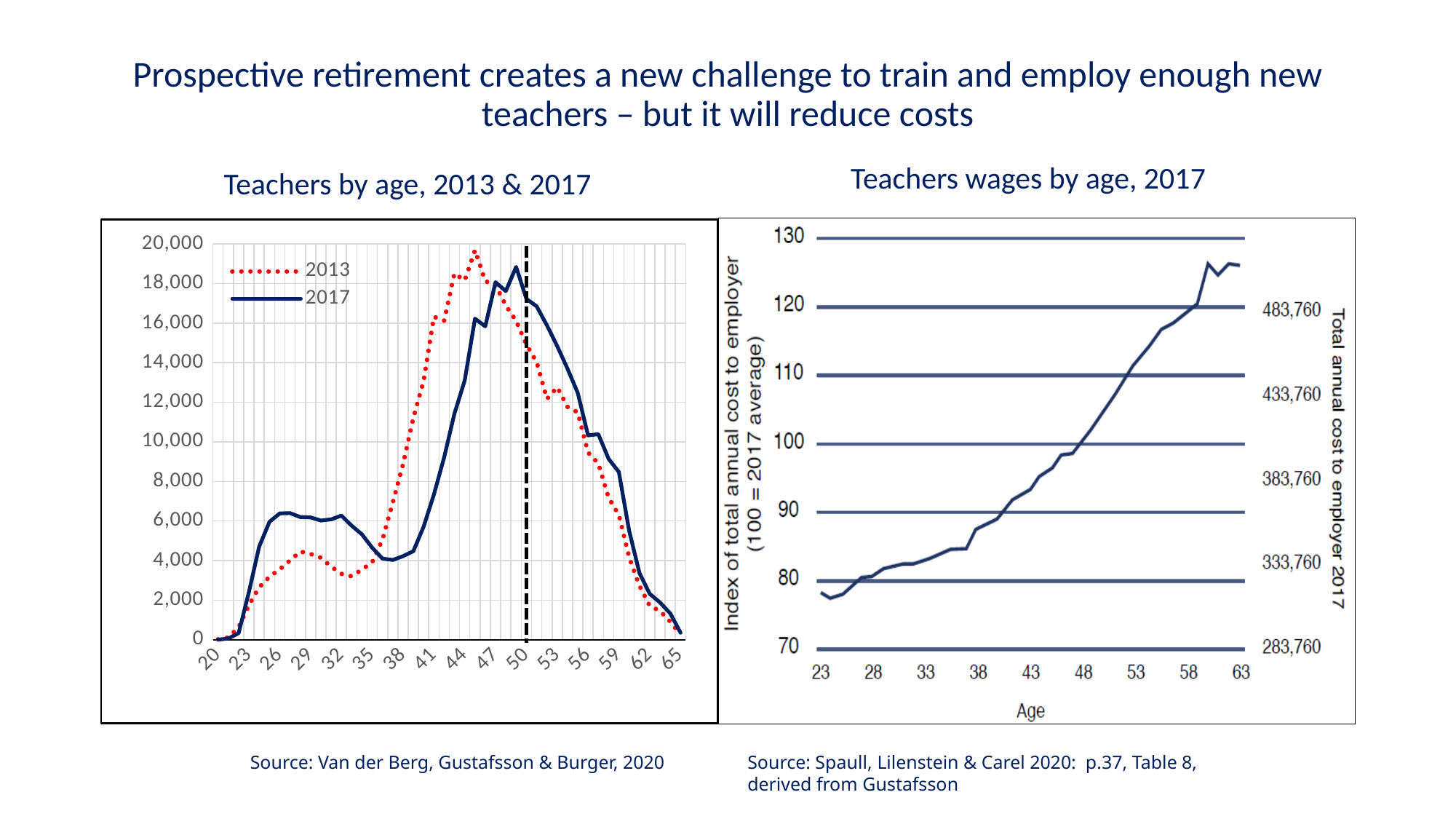
In the 'Teachers wages by age, 2017' chart, is the index value at age 63 greater or less than 120? greater In the 'Teachers by age, 2013 & 2017' chart, at which age is the dashed vertical line drawn? 50 In the 'Teachers by age, 2013 & 2017' chart, is the 2017 value at age 38 greater or less than 6,000? less What kind of chart is the 'Teachers by age, 2013 & 2017' chart on the left? line chart What kind of chart is the 'Teachers wages by age, 2017' chart on the right? line chart In the 'Teachers by age, 2013 & 2017' chart, is the 2013 value at age 29 greater or less than 6,000? less In the 'Teachers wages by age, 2017' chart, does the index of total annual cost to employer rise or fall as age increases? rise In the 'Teachers by age, 2013 & 2017' chart, which series has the higher value at age 26, 2013 or 2017? 2017 How many series does the legend of the 'Teachers by age, 2013 & 2017' chart list? 2 In the 'Teachers by age, 2013 & 2017' chart, which series has the higher value at age 44, 2013 or 2017? 2013